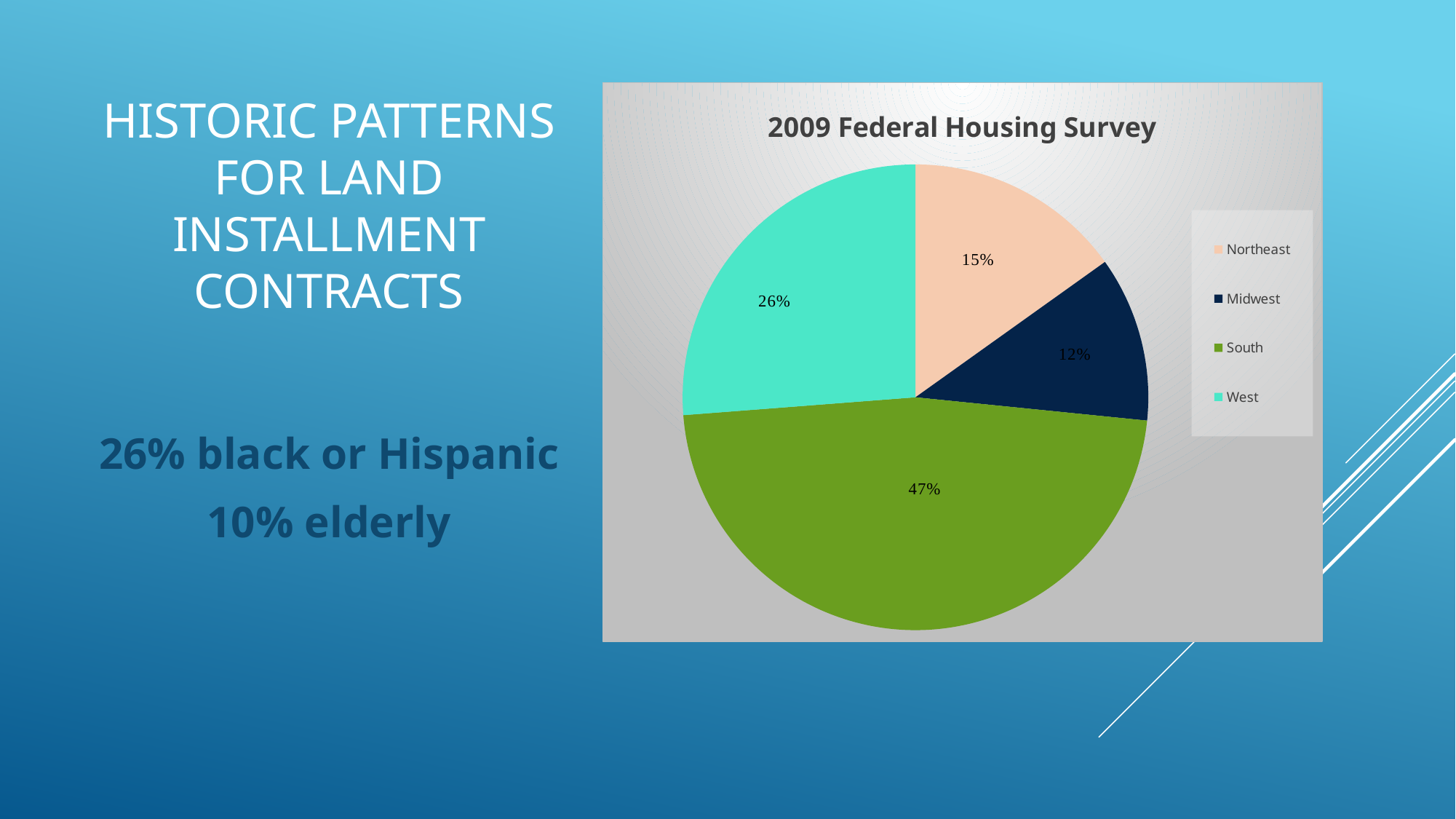
How many slices does the pie chart have? 4 Which region has the largest slice of the pie? South What is the value shown for the Northeast slice? 15% What is the difference in percentage points between the South and West slices? 21 Which region has the smallest slice of the pie? Midwest What colour is the South slice in the pie chart? Green What is the value shown for the West slice? 26% What is the title of the chart? 2009 Federal Housing Survey What share of the pie does the South slice represent? 47% What kind of chart is shown on the slide? Pie chart What is the value shown for the Midwest slice? 12% Which slice is larger, Northeast or Midwest? Northeast